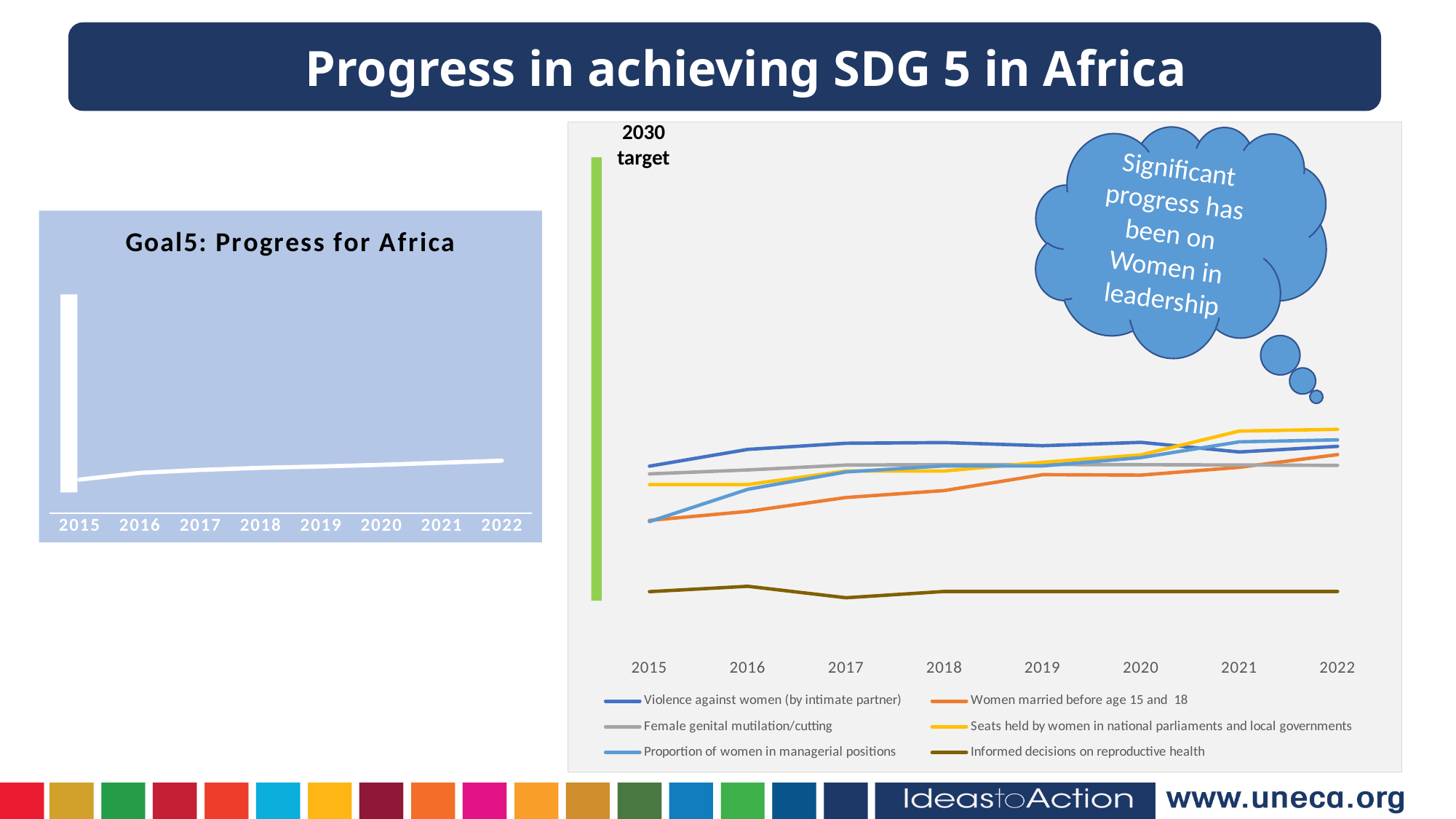
What kind of chart is the chart on the right of the slide with the six-entry legend? line chart In the right-hand chart, which series has the highest value in 2022? Seats held by women in national parliaments and local governments What kind of chart is the chart titled "Goal5: Progress for Africa" on the left of the slide? line chart In the right-hand chart, does the line for "Proportion of women in managerial positions" rise or fall from 2015 to 2022? rise How many years are shown on the x axis of the chart titled "Goal5: Progress for Africa"? 8 In the chart titled "Goal5: Progress for Africa", does the line rise or fall from 2015 to 2022? rise In the right-hand chart, does the line for "Women married before age 15 and 18" rise or fall from 2015 to 2022? rise How many years are shown on the x axis of the right-hand chart? 8 In the right-hand chart, which series has the lowest value in 2022? Informed decisions on reproductive health What is the title of the chart on the left of the slide? Goal5: Progress for Africa How many series does the legend of the right-hand chart list? 6 In the right-hand chart, which is higher in 2015: "Violence against women (by intimate partner)" or "Informed decisions on reproductive health"? Violence against women (by intimate partner)